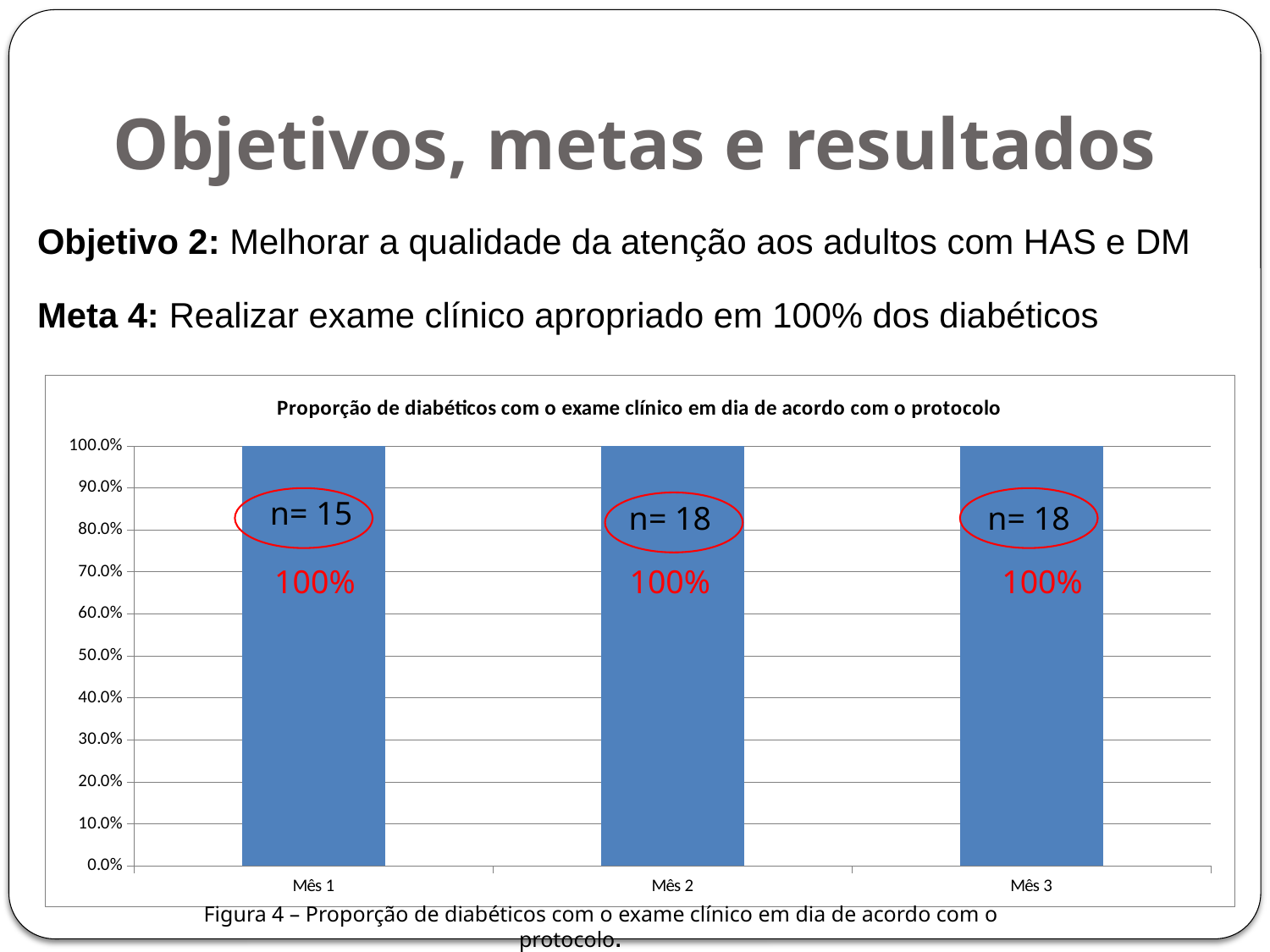
What is the difference between the values for Mês 1 and Mês 3? 0% What kind of chart is shown on the slide? Bar chart What is the title of the chart? Proporção de diabéticos com o exame clínico em dia de acordo com o protocolo What is the n value annotated on the bar for Mês 1? n= 15 How many months (categories) are shown on the x axis? 3 What is the highest value shown on the y axis? 100.0% What is the value for Mês 3? 100% What is the value for Mês 2? 100% Do the values rise, fall or stay the same from Mês 1 to Mês 3? Stay the same What is the value for Mês 1? 100% Is the value for Mês 2 greater or less than 50.0%? greater